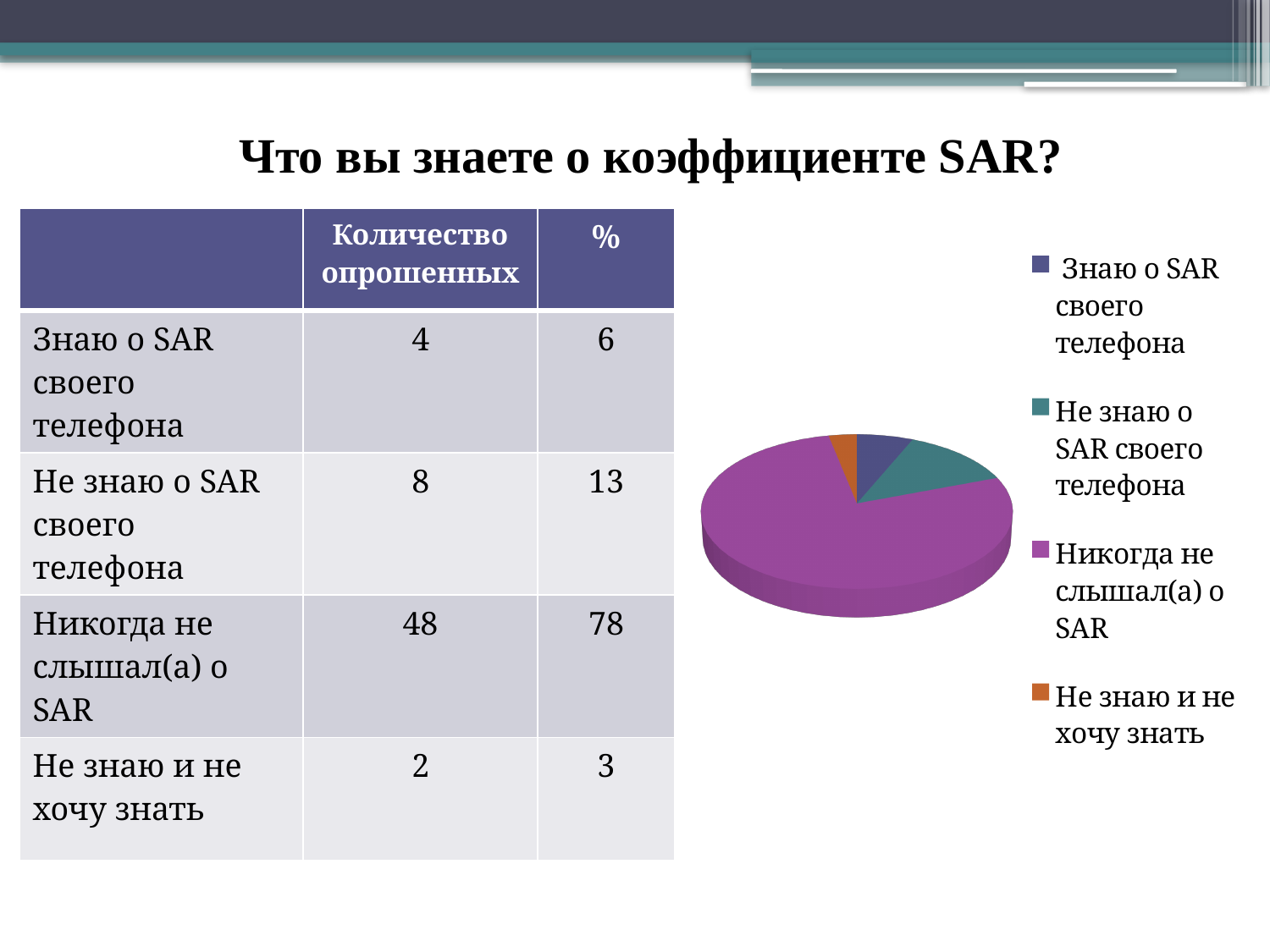
How many slices does the pie chart have? 4 What kind of chart is shown on the slide? pie chart What is the title of the slide containing the pie chart? Что вы знаете о коэффициенте SAR? According to the slide, what share of respondents does the "Никогда не слышал(а) о SAR" slice represent? 78 According to the slide, how many respondents are in the "Знаю о SAR своего телефона" category? 4 According to the slide, what share of respondents does the "Не знаю о SAR своего телефона" slice represent? 13 Which category has the smallest slice in the pie chart? Не знаю и не хочу знать What colour is the largest slice of the pie chart? purple In the pie chart, which slice is larger: "Никогда не слышал(а) о SAR" or "Не знаю о SAR своего телефона"? Никогда не слышал(а) о SAR In the pie chart, which slice is larger: "Не знаю о SAR своего телефона" or "Знаю о SAR своего телефона"? Не знаю о SAR своего телефона Which category has the largest slice in the pie chart? Никогда не слышал(а) о SAR How many entries does the legend of the pie chart list? 4